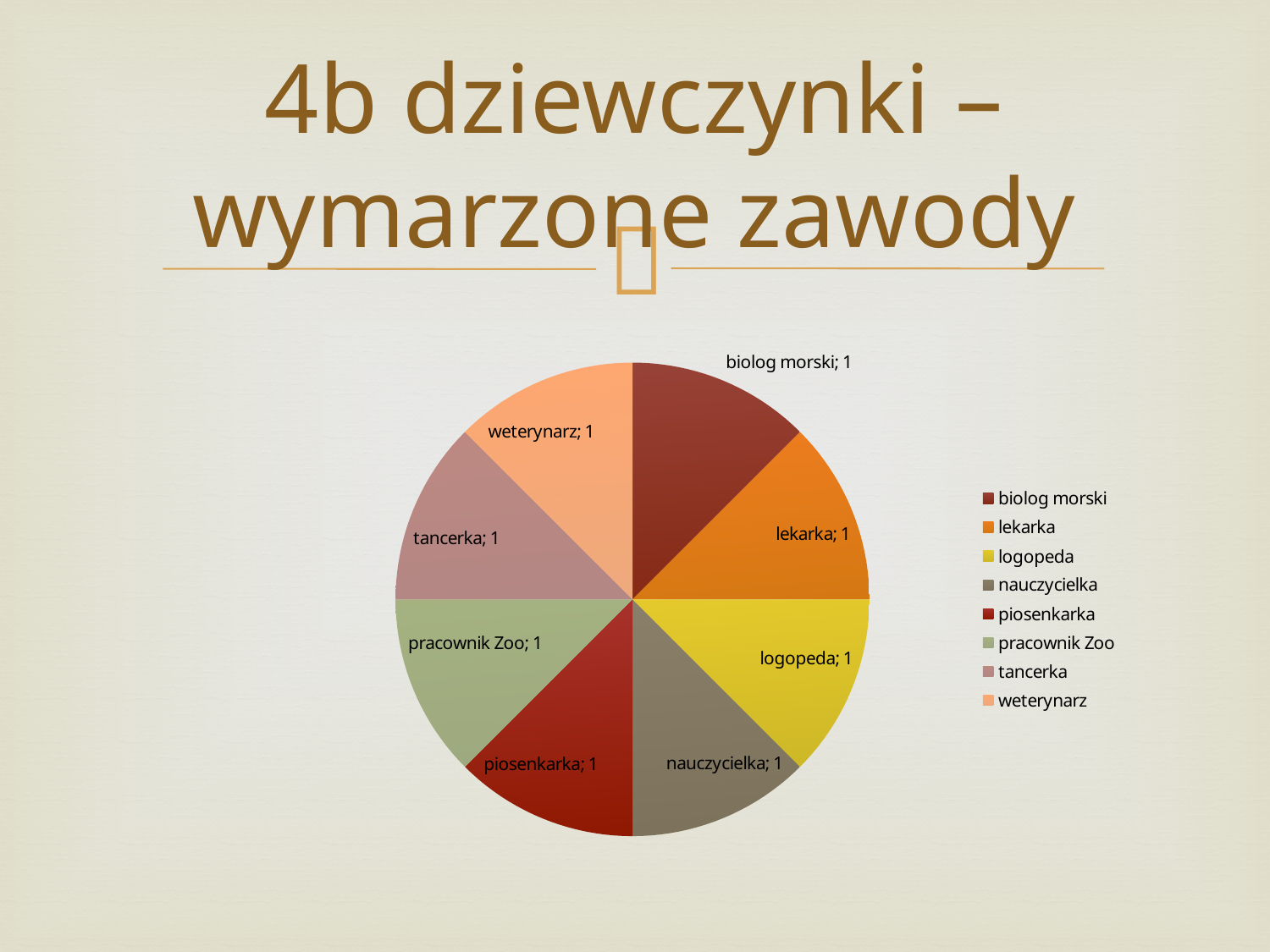
What kind of chart is shown on the slide? pie chart Which legend entry is listed first in the pie chart's legend? biolog morski What is the value shown for the slice labelled "weterynarz"? 1 What share of the pie does the "tancerka" slice represent? 12.5% How many slices does the pie chart have? 8 What is the value shown for the slice labelled "pracownik Zoo"? 1 What is the title of the slide containing the pie chart? 4b dziewczynki – wymarzone zawody What is the value shown for the slice labelled "biolog morski"? 1 What is the value shown for the slice labelled "lekarka"? 1 What share of the pie does the "logopeda" slice represent? 12.5% How many entries does the legend of the pie chart list? 8 What is the total of all the values shown on the pie chart? 8